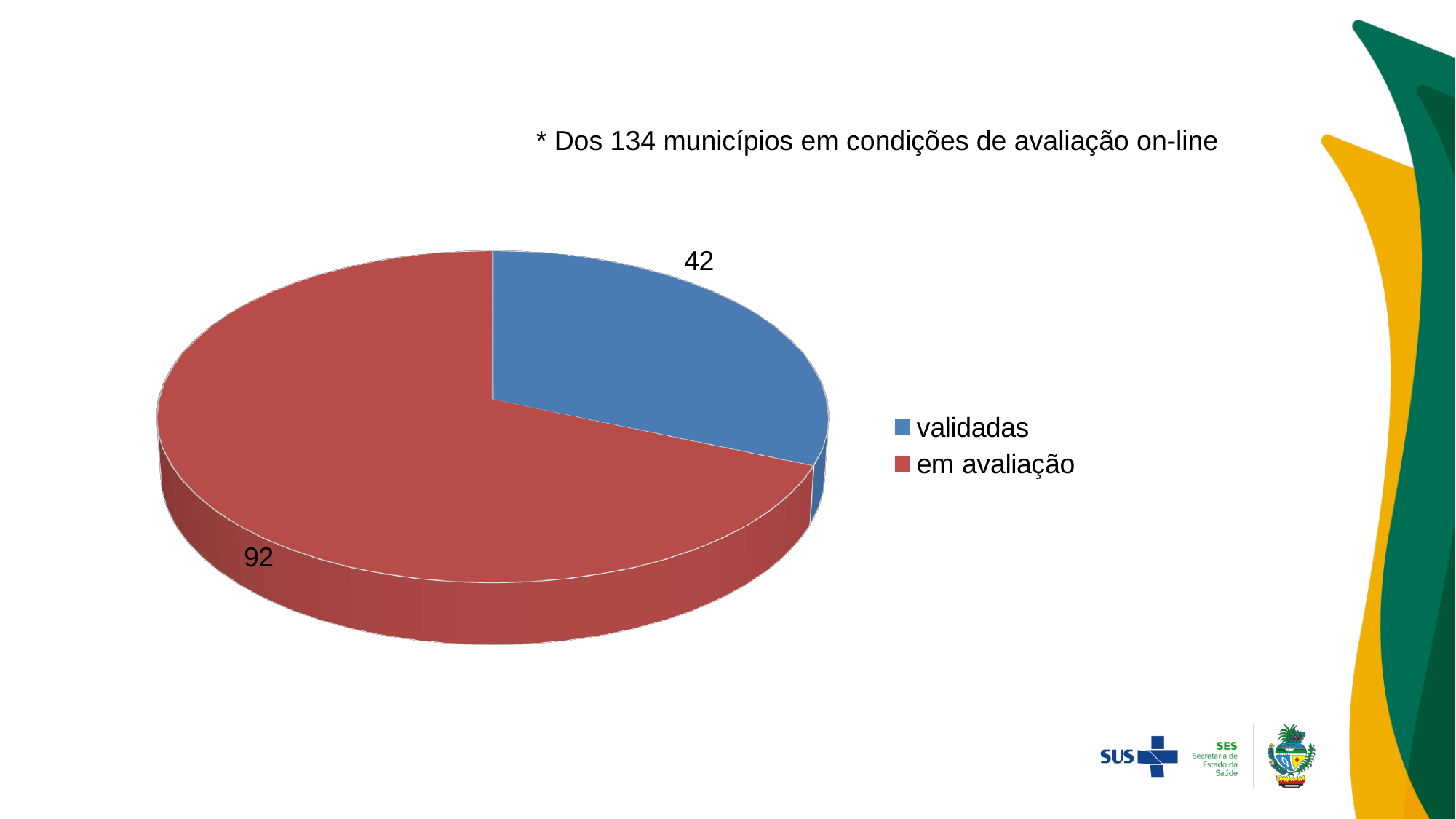
Which category has the largest slice? em avaliação Which is larger, the value for "validadas" or the value for "em avaliação"? em avaliação Which category has the smallest slice? validadas How many slices does the pie chart have? 2 What colour is the "validadas" slice? blue How many entries does the legend list? 2 What is the value for "em avaliação"? 92 What is the total of the two slices? 134 What is the difference between the values for "em avaliação" and "validadas"? 50 What type of chart is shown on the slide? pie chart What is the value for "validadas"? 42 What colour is the "em avaliação" slice? red